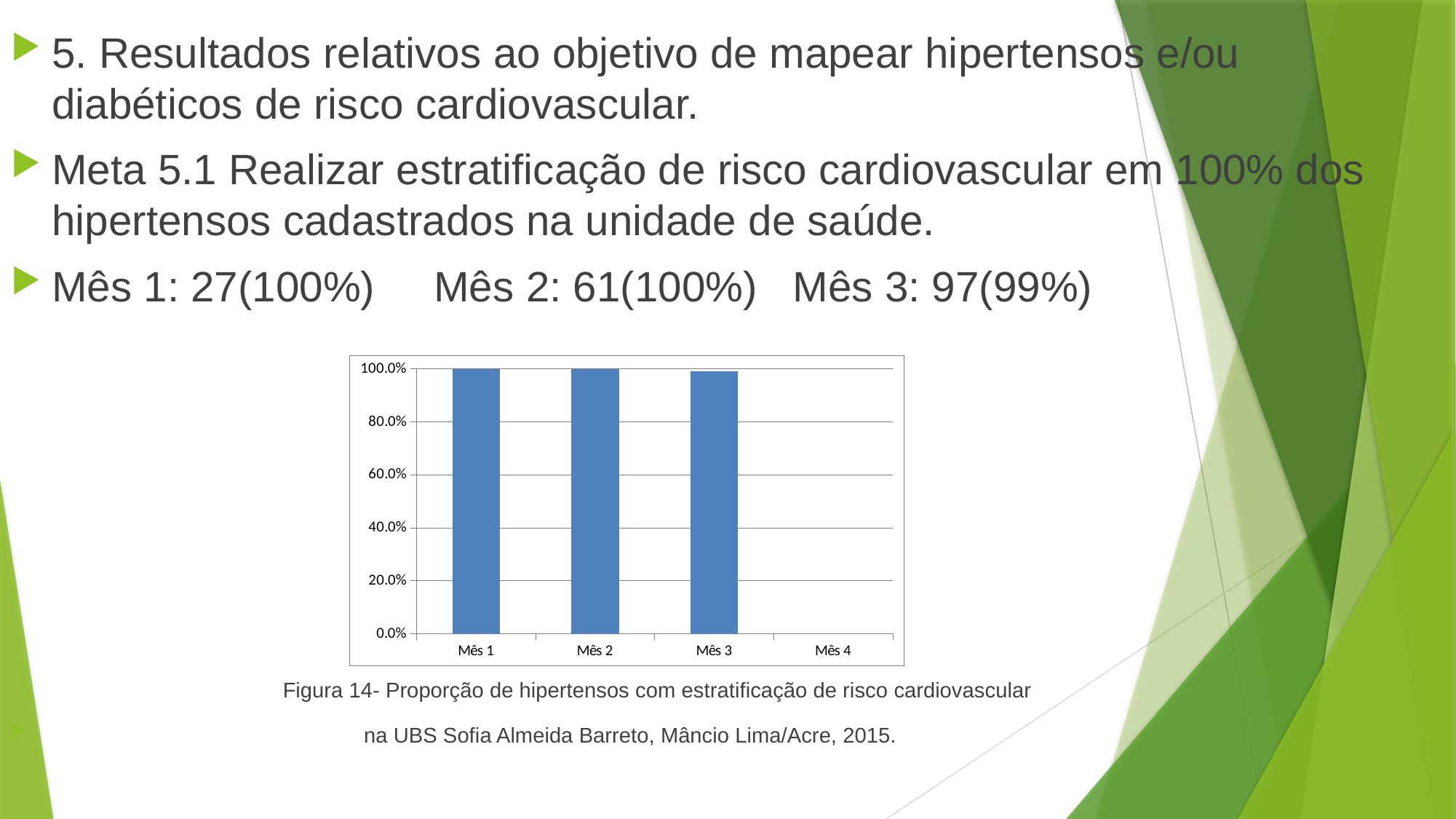
What kind of chart is shown on the slide? bar chart What is the value for Mês 2 in the chart? 100.0% How many bars are plotted in the chart? 3 Which category on the x axis has no bar plotted? Mês 4 What is the value for Mês 1 in the chart? 100.0% Is the value for Mês 1 greater or less than 60.0%? greater What is the highest value shown on the vertical axis of the chart? 100.0% Is the value for Mês 3 greater or less than 80.0%? greater How many categories are shown on the x axis of the chart? 4 Is the value for Mês 2 greater or less than 20.0%? greater